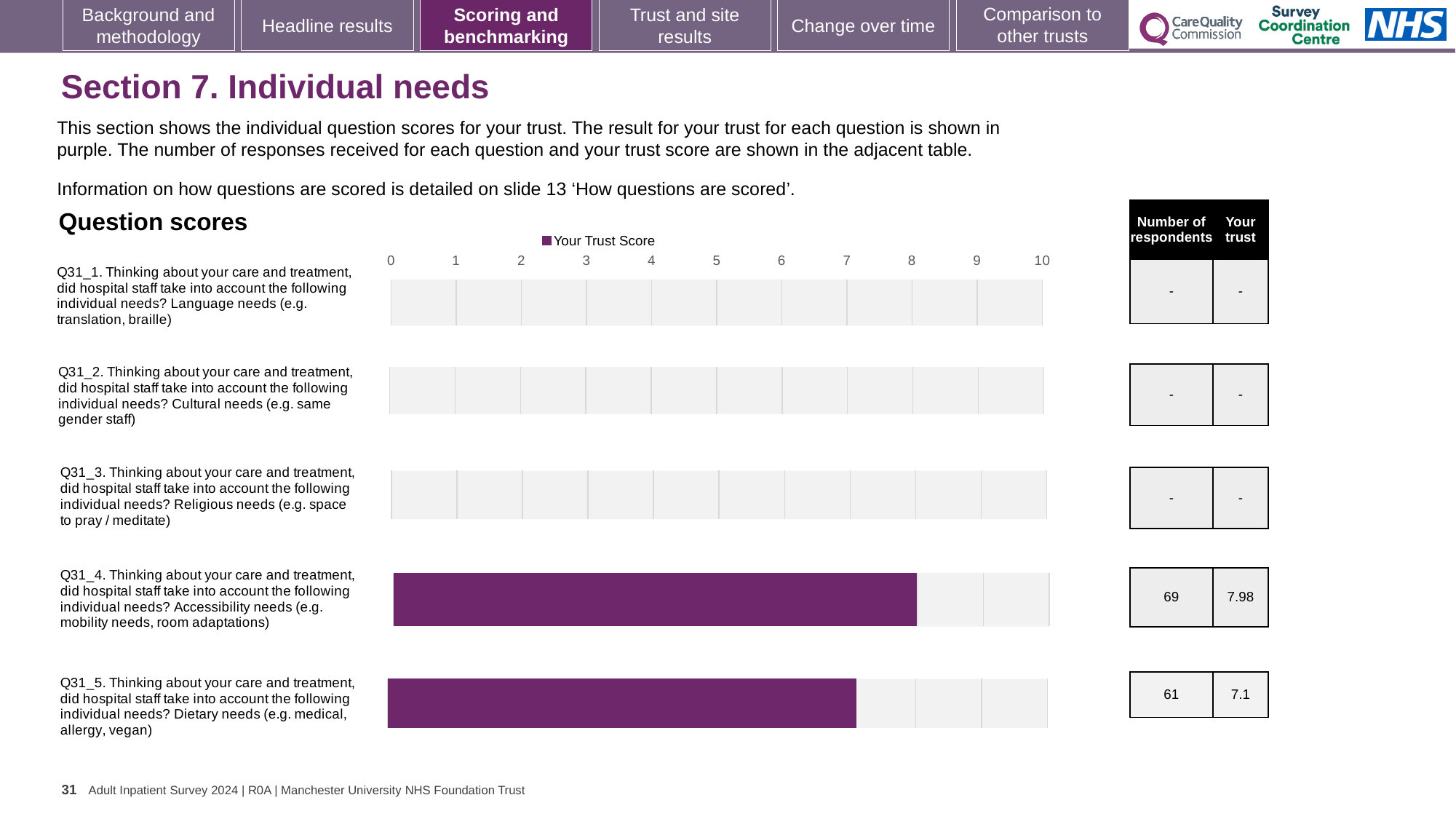
What is the trust score for Q31_5 (Dietary needs)? 7.1 What is the difference between the trust scores for Q31_4 (Accessibility needs) and Q31_5 (Dietary needs)? 0.88 How many of the questions in the Question scores chart have a plotted trust score bar? 2 Which question has the higher trust score, Q31_4 (Accessibility needs) or Q31_5 (Dietary needs)? Q31_4 What is the trust score for Q31_4 (Accessibility needs)? 7.98 Is the trust score for Q31_5 (Dietary needs) greater or less than 8? less What is the maximum value shown on the score axis of the Question scores chart? 10 How many questions are listed in the Question scores chart? 5 How many respondents answered Q31_4 (Accessibility needs)? 69 What type of chart is used to show the question scores? Bar chart How many respondents answered Q31_5 (Dietary needs)? 61 Is the trust score for Q31_4 (Accessibility needs) greater or less than 7? greater